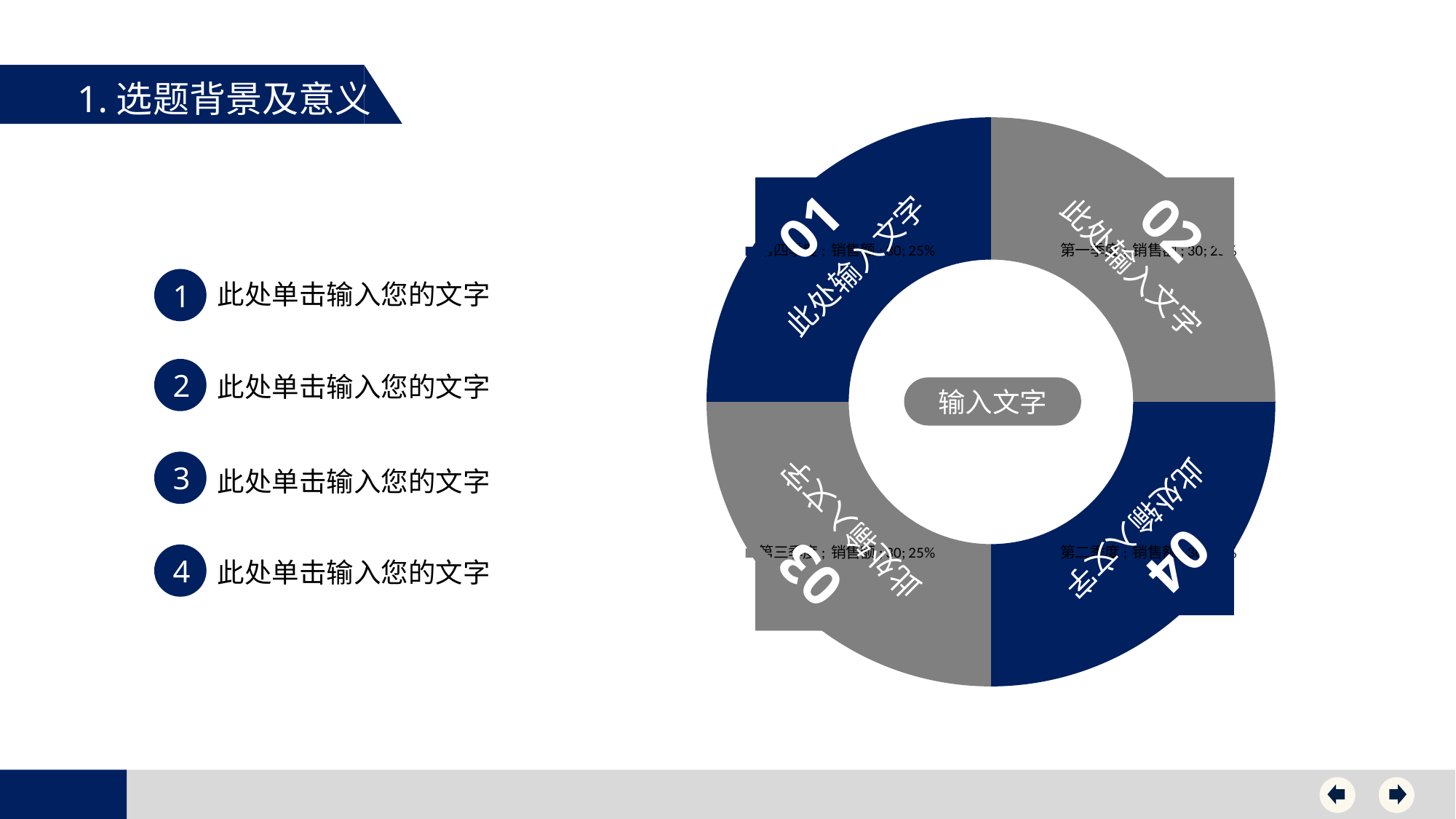
What is the 销售额 value for 第四季度 in the doughnut chart? 30 What share of the doughnut chart does 第四季度 represent? 25% How many slices does the doughnut chart have? 4 What share of the doughnut chart does 第三季度 represent? 25% What is the 销售额 value for 第三季度 in the doughnut chart? 30 What text is shown in the centre of the doughnut chart? 输入文字 What is the name of the data series plotted in the doughnut chart? 销售额 What kind of chart is shown on the slide? doughnut (pie) chart